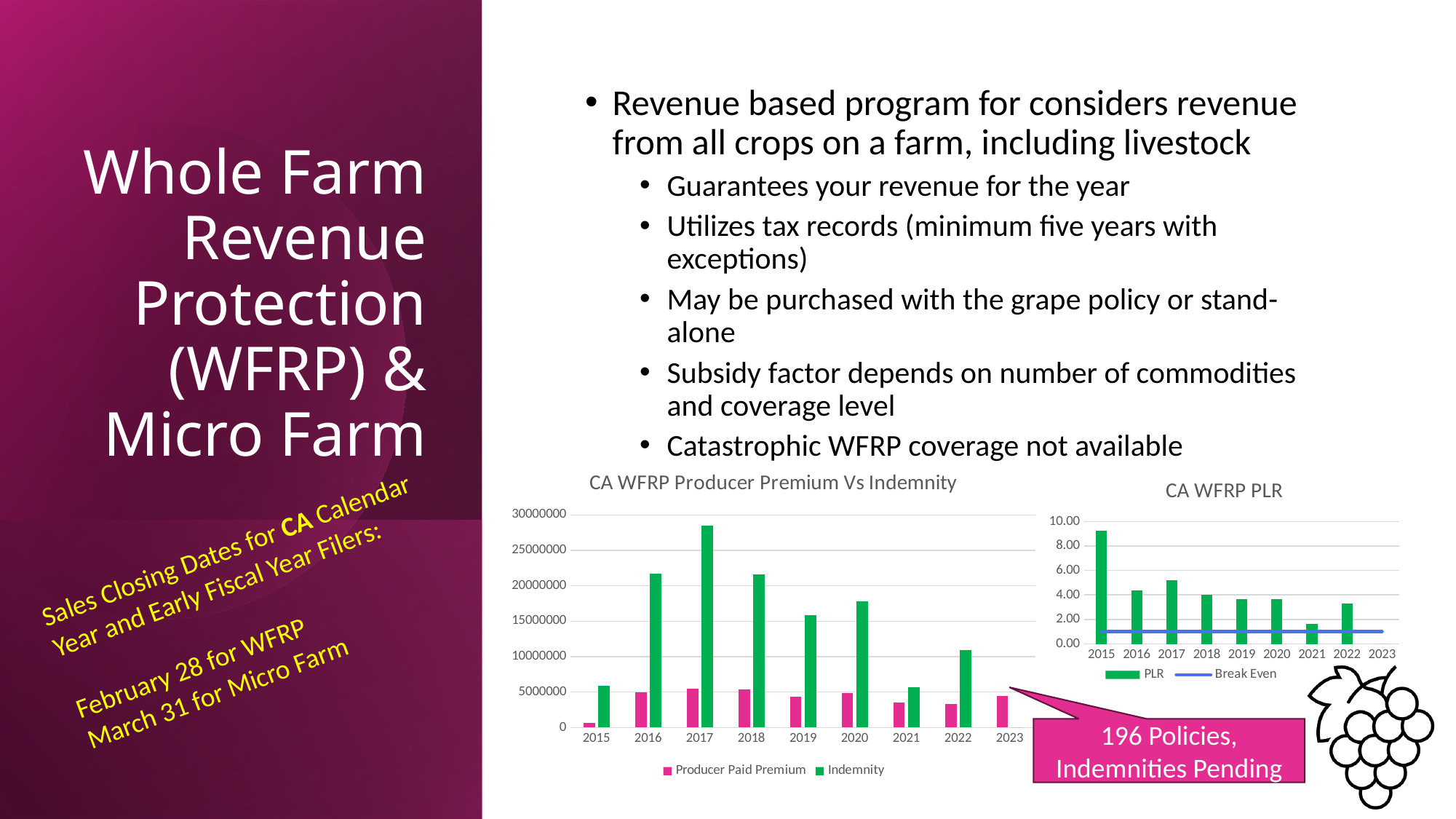
In the 'CA WFRP Producer Premium Vs Indemnity' chart, is the Indemnity for 2020 greater or less than 20000000? less In the 'CA WFRP Producer Premium Vs Indemnity' chart, which year has the lowest Producer Paid Premium? 2015 In the 'CA WFRP Producer Premium Vs Indemnity' chart, how many years are shown on the x axis? 9 In the 'CA WFRP Producer Premium Vs Indemnity' chart, which year has the highest Indemnity? 2017 In the 'CA WFRP Producer Premium Vs Indemnity' chart, how many series does the legend list? 2 In the 'CA WFRP Producer Premium Vs Indemnity' chart, which is larger, the Indemnity for 2017 or the Indemnity for 2020? 2017 What kind of chart is the 'CA WFRP Producer Premium Vs Indemnity' chart? bar chart In the 'CA WFRP PLR' chart, which year has the highest PLR? 2015 In the 'CA WFRP PLR' chart, is the PLR for 2015 greater or less than 8.00? greater In the 'CA WFRP PLR' chart, what are the two entries in the legend? PLR and Break Even In the 'CA WFRP Producer Premium Vs Indemnity' chart, is the Indemnity for 2017 greater or less than 25000000? greater In the 'CA WFRP PLR' chart, which year has the lowest PLR bar? 2021